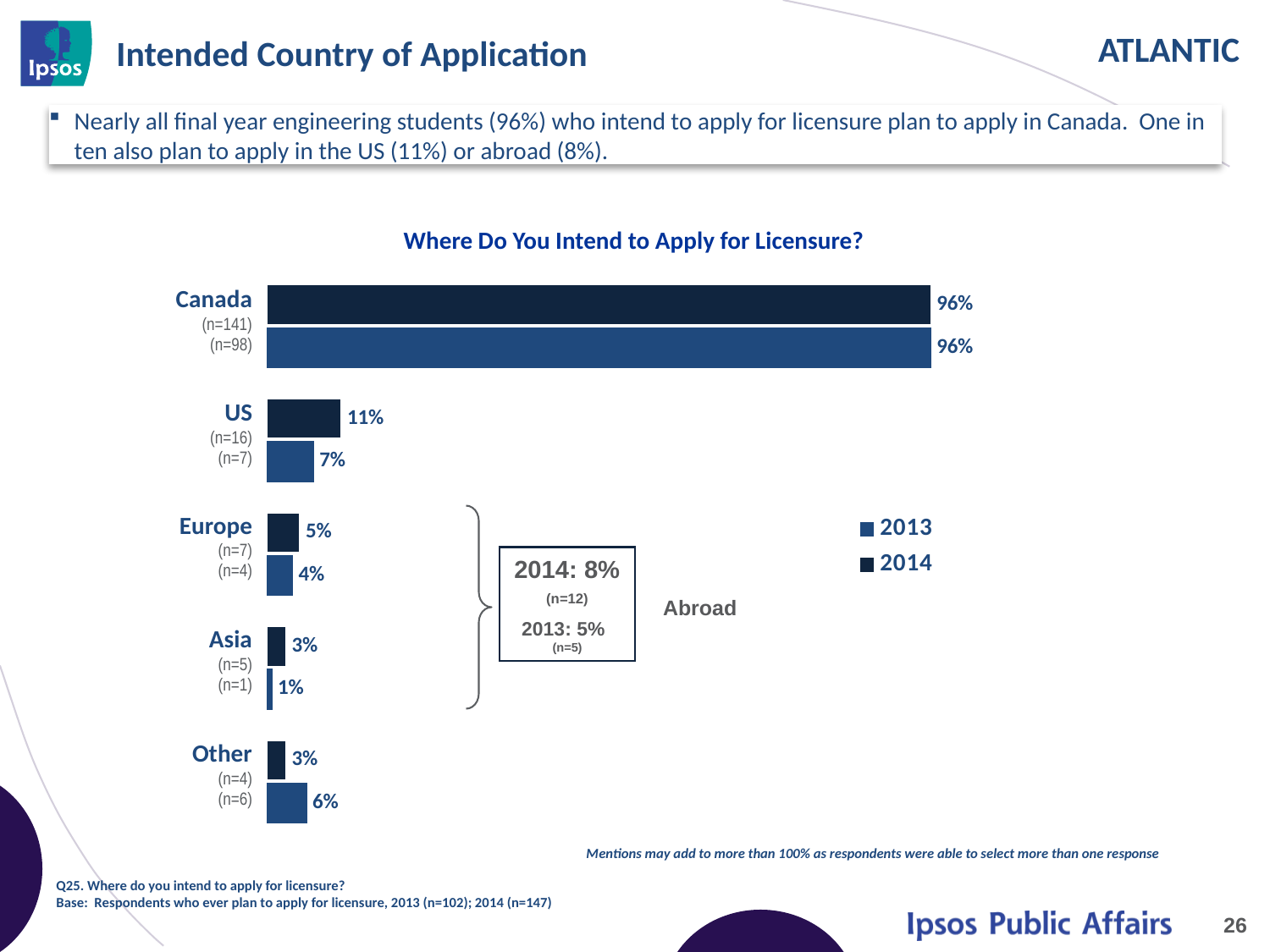
What is the 2014 value for Asia? 3% What is the 2013 value for Other? 6% What percentage of respondents intended to apply in the US in 2013? 7% What percentage of respondents intended to apply in the US in 2014? 11% How many series does the legend list? 2 What percentage of respondents intended to apply in Canada in 2014? 96% How many countries or regions are listed as categories in the chart? 5 Which category has the lowest value in 2013? Asia What is the difference between the 2014 and 2013 values for the US? 4% For Other, which year has the larger value, 2013 or 2014? 2013 Which country or region has the highest value in 2014? Canada What kind of chart is shown under the title "Where Do You Intend to Apply for Licensure?"? bar chart